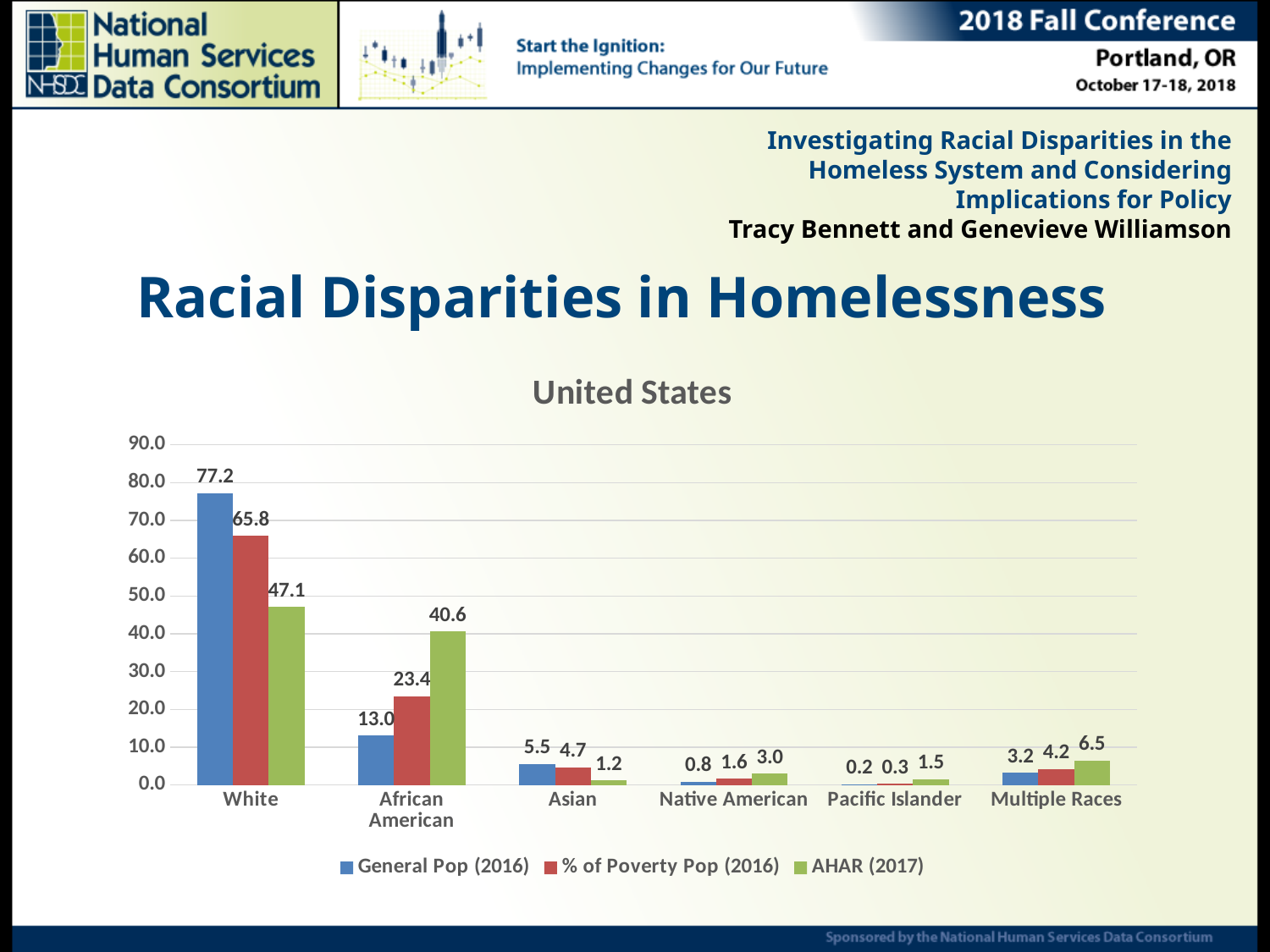
What is the AHAR (2017) value for Multiple Races? 6.5 What is the difference between the General Pop (2016) and AHAR (2017) values for White? 30.1 What is the AHAR (2017) value for African American? 40.6 Which category has the lowest General Pop (2016) value? Pacific Islander What is the difference between the AHAR (2017) and General Pop (2016) values for African American? 27.6 What is the General Pop (2016) value for White? 77.2 How many categories are shown on the x axis? 6 What type of chart is shown? Bar chart Which is larger for Asian: the General Pop (2016) value or the AHAR (2017) value? General Pop (2016) What is the % of Poverty Pop (2016) value for Asian? 4.7 Which category has the highest AHAR (2017) value? White How many series does the legend list? 3